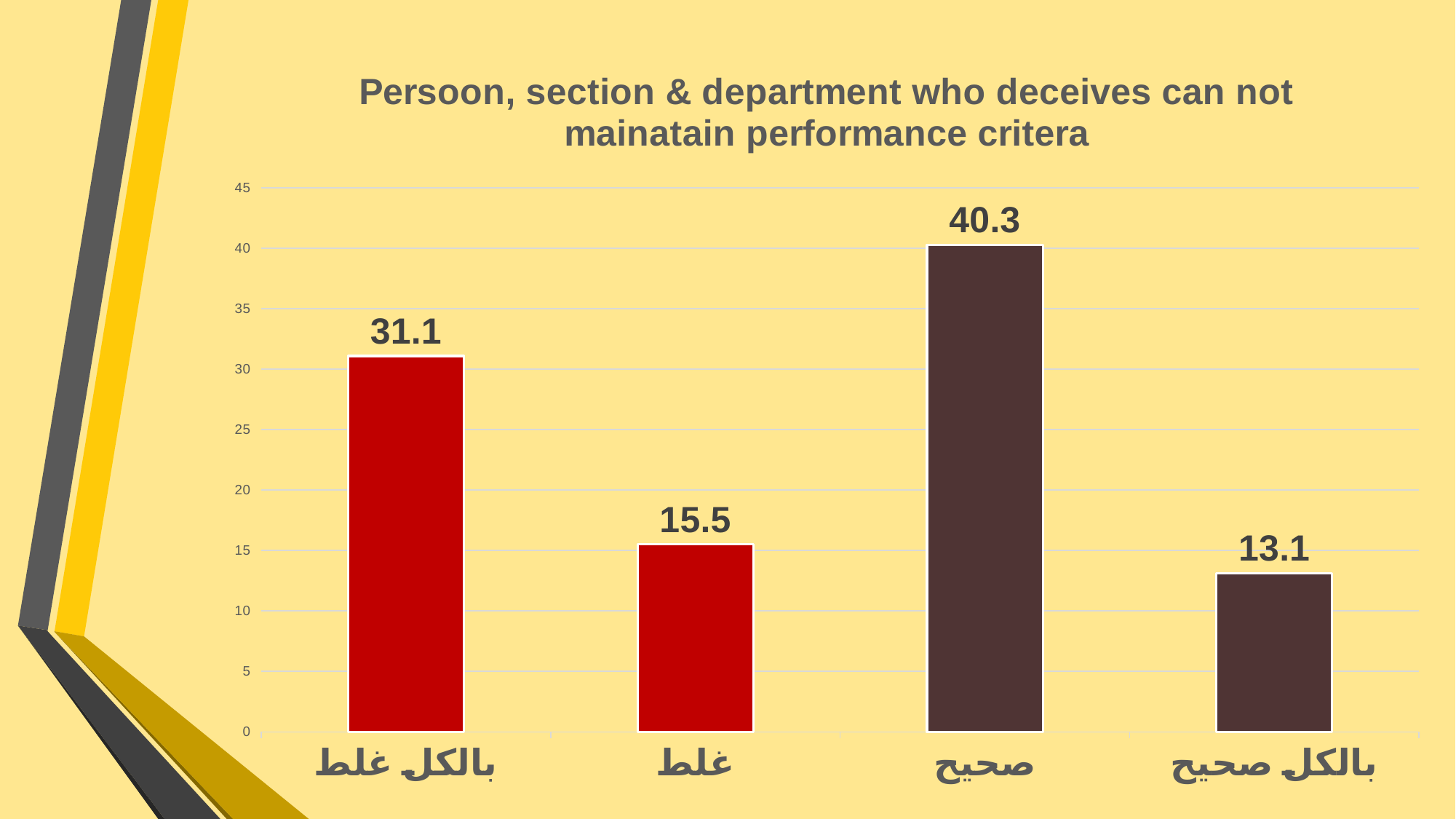
What is the difference between the values for صحيح and بالكل غلط? 9.2 What is the difference between the values for غلط and بالكل صحيح? 2.4 Which is larger, the value for بالكل غلط or the value for غلط? بالكل غلط What is the value for بالكل صحيح? 13.1 How many categories are shown on the x axis? 4 What is the value for بالكل غلط? 31.1 Which category has the highest value? صحيح What kind of chart is shown on the slide? bar chart Which category has the lowest value? بالكل صحيح Is the value for صحيح greater or less than 35? greater What is the value for غلط? 15.5 What is the value for صحيح? 40.3